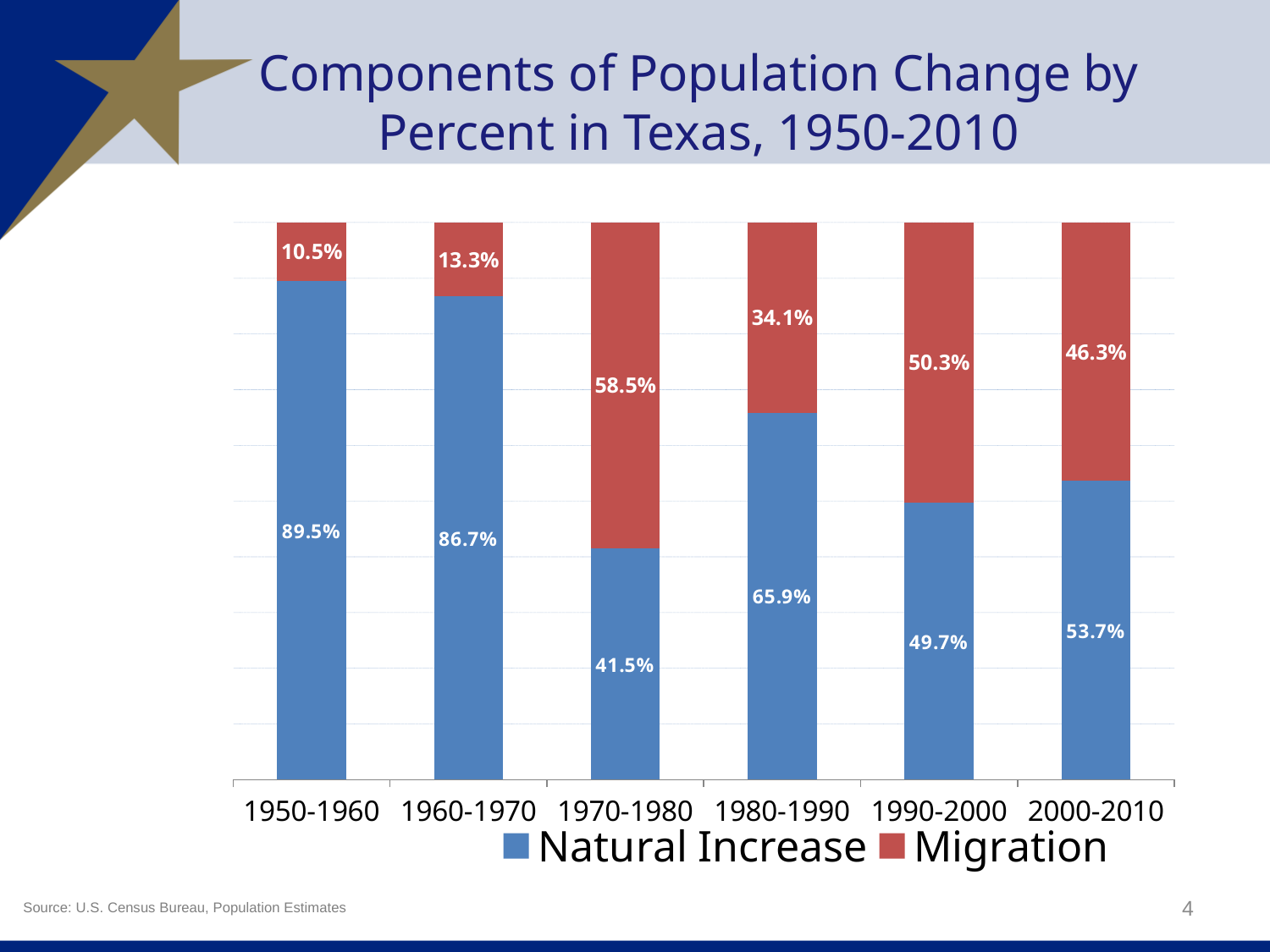
What is the Natural Increase value for 2000-2010? 53.7% Which decade has the highest Migration share of population change? 1970-1980 How many percentage points higher is the Migration share in 1970-1980 than in 1950-1960? 48.0 percentage points What is the Migration share of population change for 1970-1980? 58.5% What percent of population change in Texas came from Natural Increase in 1950-1960? 89.5% How many series does the legend list? 2 What is the total of the stacked bar for 1990-2000? 100% What kind of chart is shown on the slide? Stacked bar chart Which decade has the lowest Natural Increase share? 1970-1980 How many decade periods are shown on the x axis? 6 Which is larger: the Natural Increase share in 1980-1990 or in 2000-2010? 1980-1990 Which decade has the lowest Migration share? 1950-1960